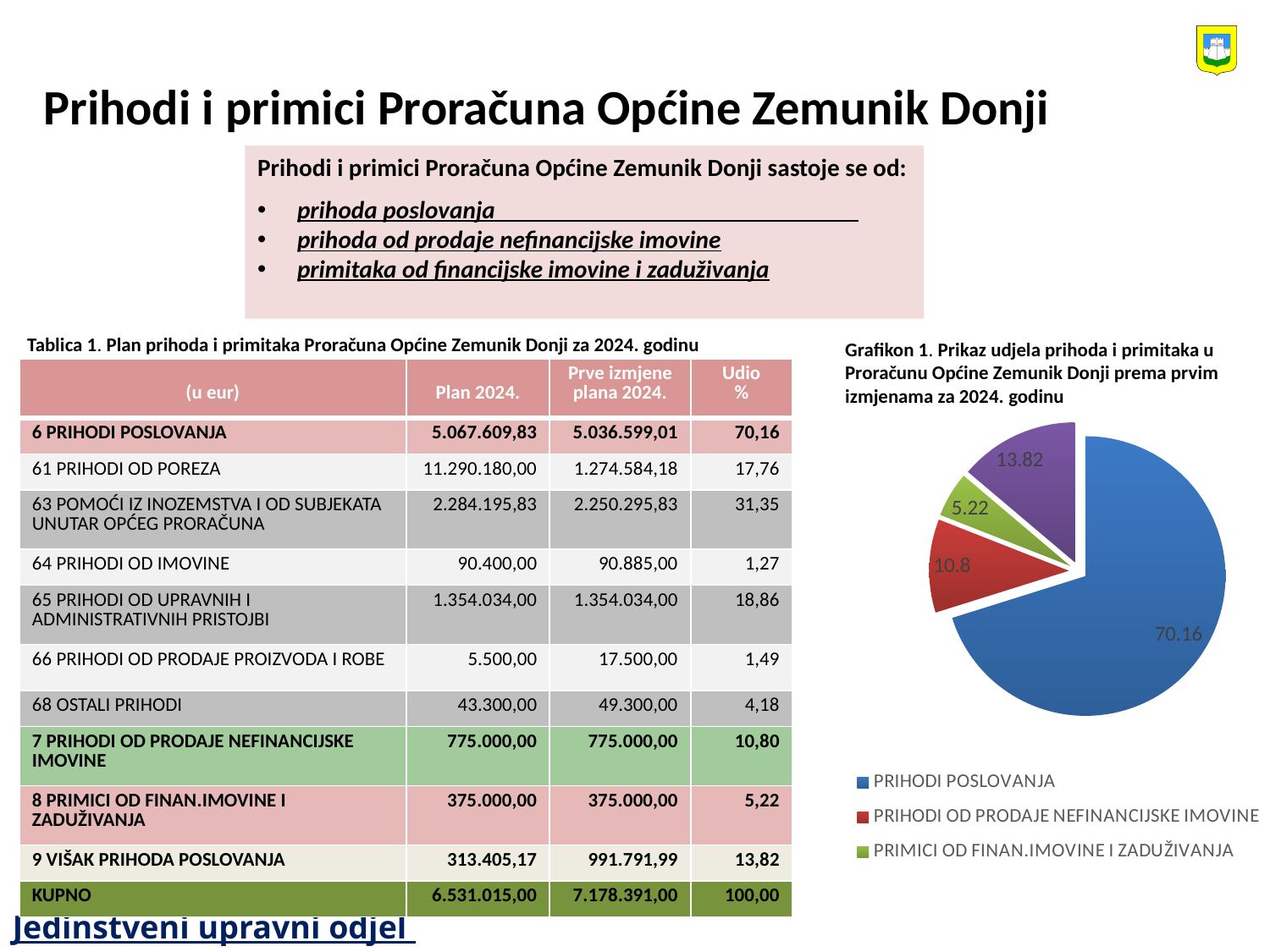
In the pie chart, what is the value shown for PRIMICI OD FINAN.IMOVINE I ZADUŽIVANJA? 5.22 In the pie chart, what is the value shown for PRIHODI POSLOVANJA? 70.16 In the pie chart, which is larger: PRIHODI OD PRODAJE NEFINANCIJSKE IMOVINE or PRIMICI OD FINAN.IMOVINE I ZADUŽIVANJA? PRIHODI OD PRODAJE NEFINANCIJSKE IMOVINE How many entries does the legend of the pie chart list? 3 What value is shown on the purple slice of the pie chart? 13.82 In the pie chart, what is the value shown for PRIHODI OD PRODAJE NEFINANCIJSKE IMOVINE? 10.8 What kind of chart is Grafikon 1 on the slide? pie chart How many slices does the pie chart have? 4 Which category has the largest slice in the pie chart? PRIHODI POSLOVANJA What colour is the slice for PRIHODI POSLOVANJA in the pie chart? blue In the pie chart, what is the difference between the values for PRIHODI POSLOVANJA and PRIHODI OD PRODAJE NEFINANCIJSKE IMOVINE? 59.36 Which legend category has the smallest slice in the pie chart? PRIMICI OD FINAN.IMOVINE I ZADUŽIVANJA